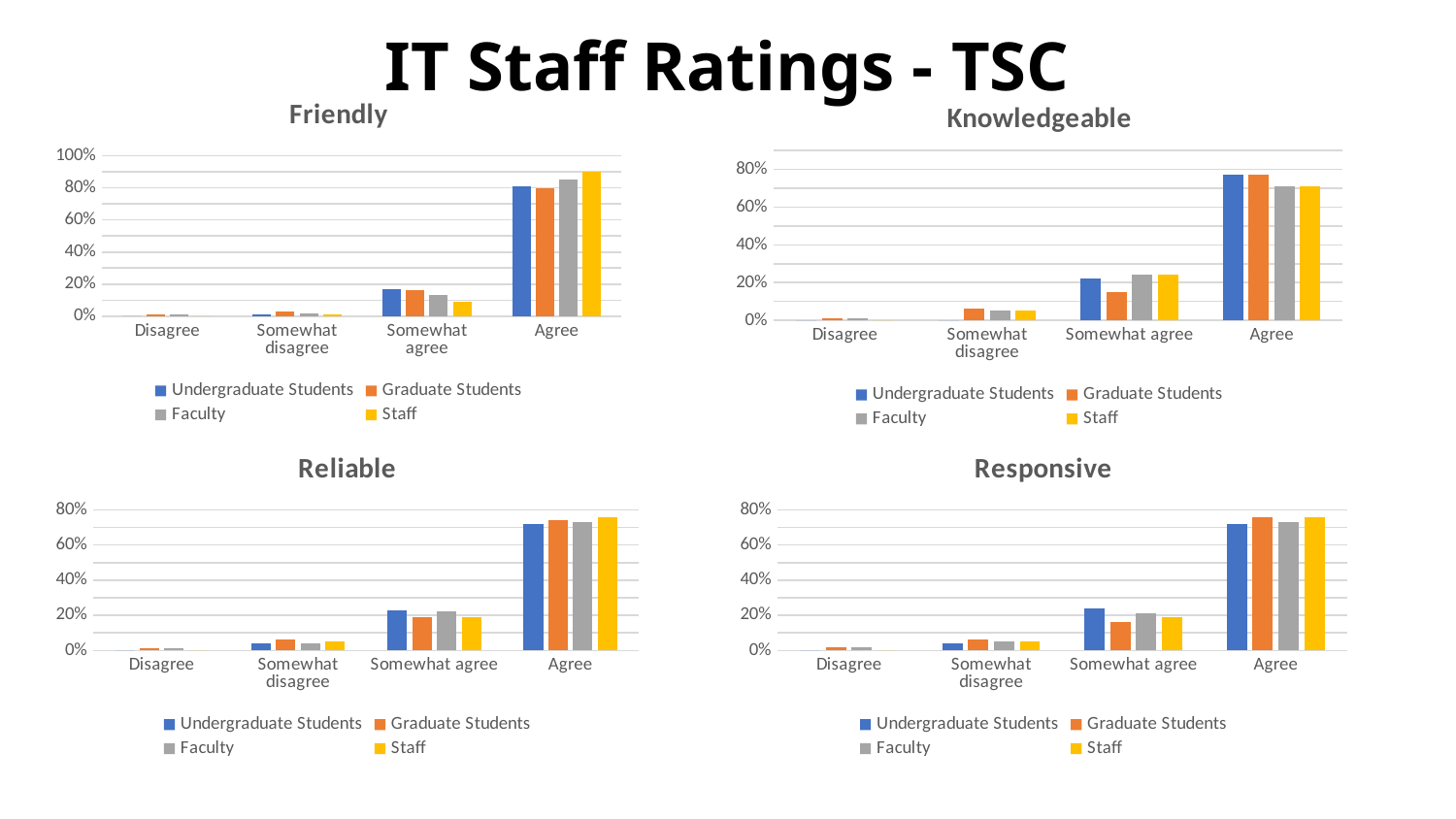
In the Friendly chart, is the value for Undergraduate Students in the Somewhat agree category greater or less than 20%? less In the Responsive chart, which group has the lowest value in the Somewhat agree category? Graduate Students In the Friendly chart, is the value for Staff in the Agree category greater or less than 80%? greater In the Friendly chart, which category has the highest values for all groups? Agree In the Knowledgeable chart, is the value for Undergraduate Students in the Agree category greater or less than 60%? greater In the Knowledgeable chart, which group has the lowest value in the Somewhat agree category? Graduate Students What kind of chart is the Friendly chart? bar chart In the Responsive chart, which is larger in the Agree category: Graduate Students or Undergraduate Students? Graduate Students How many series does the legend of the Knowledgeable chart list? 4 Which colour represents Staff in the legend of the Responsive chart? yellow How many categories are shown on the x axis of the Reliable chart? 4